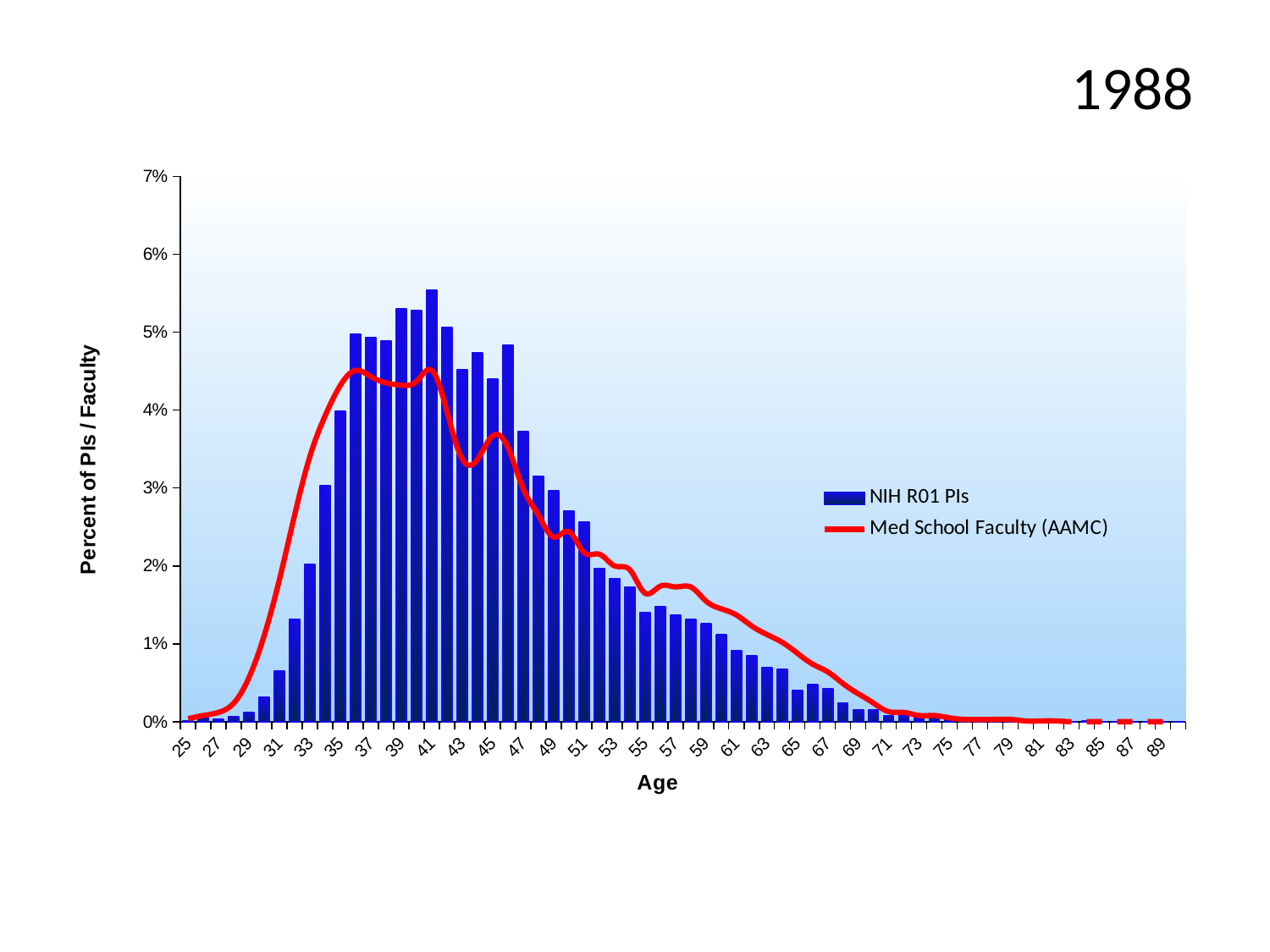
At age 41, which is larger: the NIH R01 PIs bar or the Med School Faculty (AAMC) line? NIH R01 PIs What is the title of the x axis? Age Is the NIH R01 PIs value at age 31 greater or less than 1%? less Is the NIH R01 PIs value at age 41 greater or less than 5%? greater Is the Med School Faculty (AAMC) value at age 55 greater or less than 1%? greater How many series does the legend list? 2 What are the two series named in the legend? NIH R01 PIs; Med School Faculty (AAMC) At which age is the NIH R01 PIs bar highest? 41 What kind of chart is shown on the slide? bar chart with a line overlay Do the NIH R01 PIs bars rise or fall from age 41 to age 71? fall